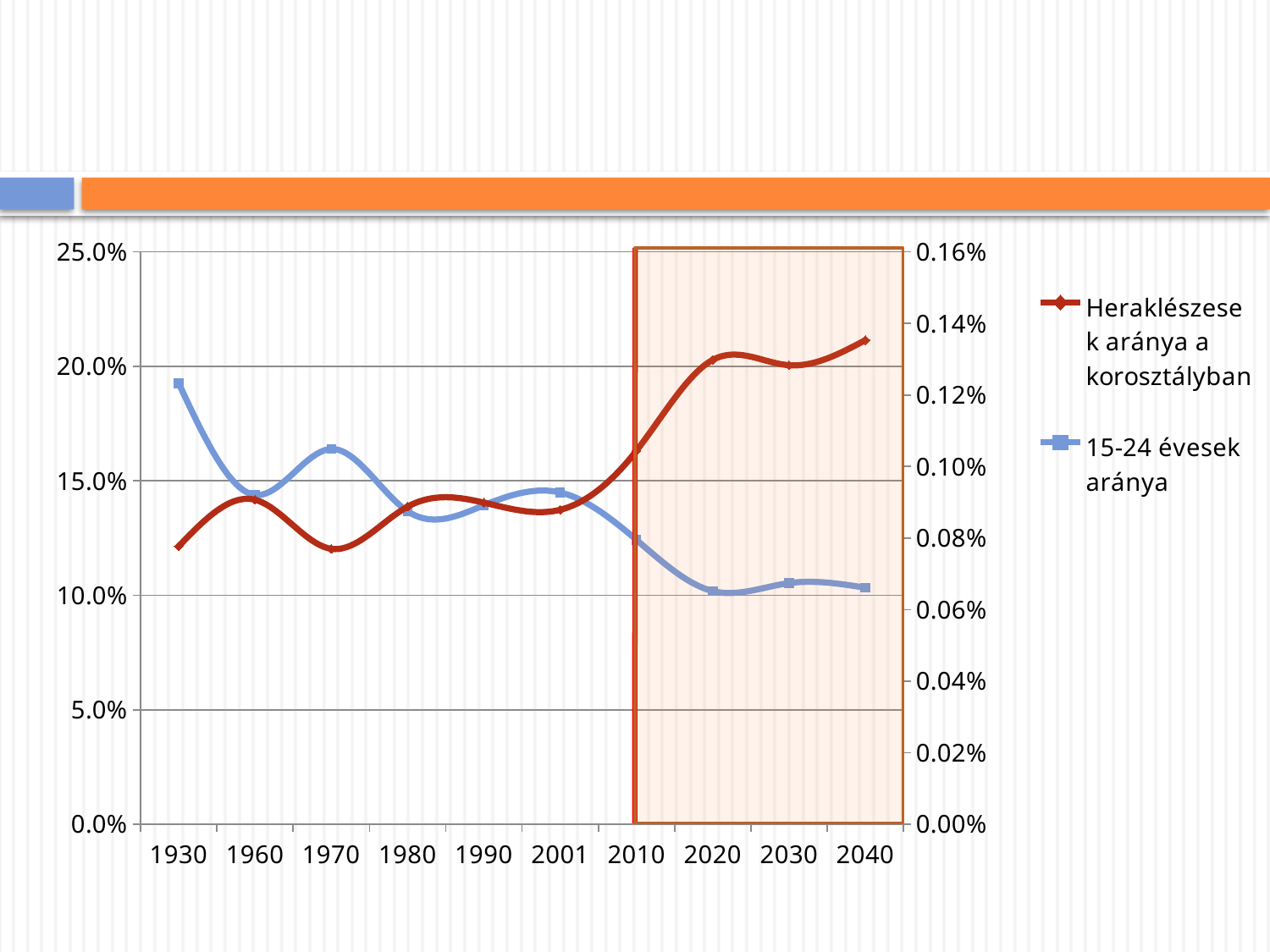
Does the 'Heraklészesek aránya a korosztályban' series rise or fall between 2001 and 2020? rise In which year does the '15-24 évesek aránya' series reach its highest point? 1930 What kind of chart is shown on the slide? line chart In which year does the 'Heraklészesek aránya a korosztályban' series reach its highest point? 2040 For the '15-24 évesek aránya' series, which year has the larger value: 1930 or 2040? 1930 How many years are marked on the x axis of the chart? 10 What colour is the line for the 'Heraklészesek aránya a korosztályban' series? red At which year on the x axis does the shaded rectangle on the chart begin? 2010 Does the '15-24 évesek aránya' series rise or fall between 2001 and 2020? fall Does the '15-24 évesek aránya' series rise or fall between 1930 and 1960? fall For the 'Heraklészesek aránya a korosztályban' series, which year has the larger value: 1930 or 2040? 2040 How many series does the legend list? 2